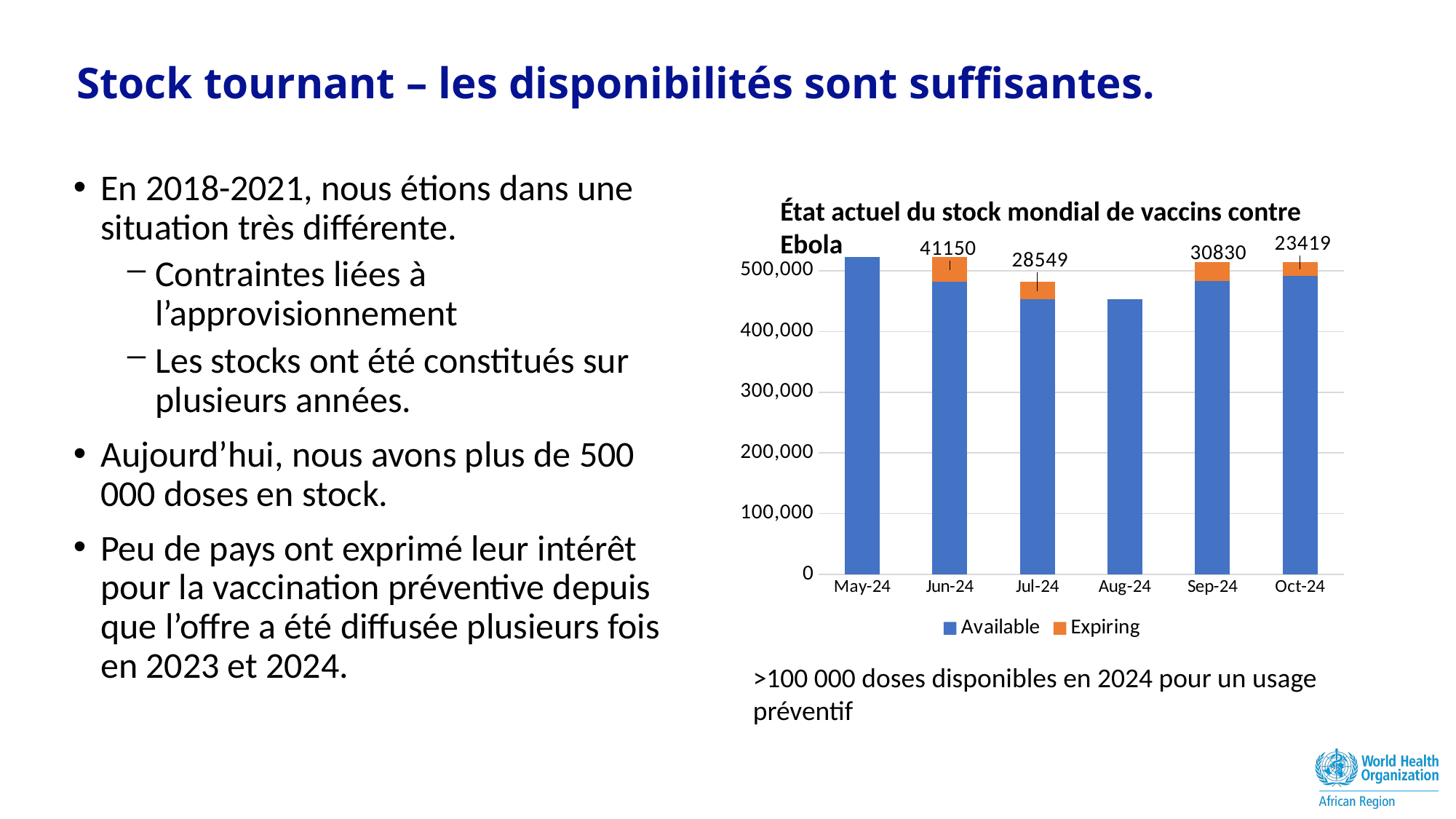
Is the total stock for Aug-24 greater or less than 500,000? less How many series does the legend list? 2 What is the Expiring value for Oct-24? 23419 What is the Expiring value for Sep-24? 30830 What kind of chart is shown on the slide? Stacked bar chart Is the total stock for May-24 greater or less than 500,000? greater Among the months with an Expiring label, which has the lowest Expiring value? Oct-24 What is the difference between the Expiring values for Jun-24 and Jul-24? 12601 Which month has the highest Expiring value? Jun-24 What is the Expiring value for Jun-24? 41150 Which is larger, the Expiring value for Jun-24 or for Sep-24? Jun-24 How many months are shown on the x axis? 6